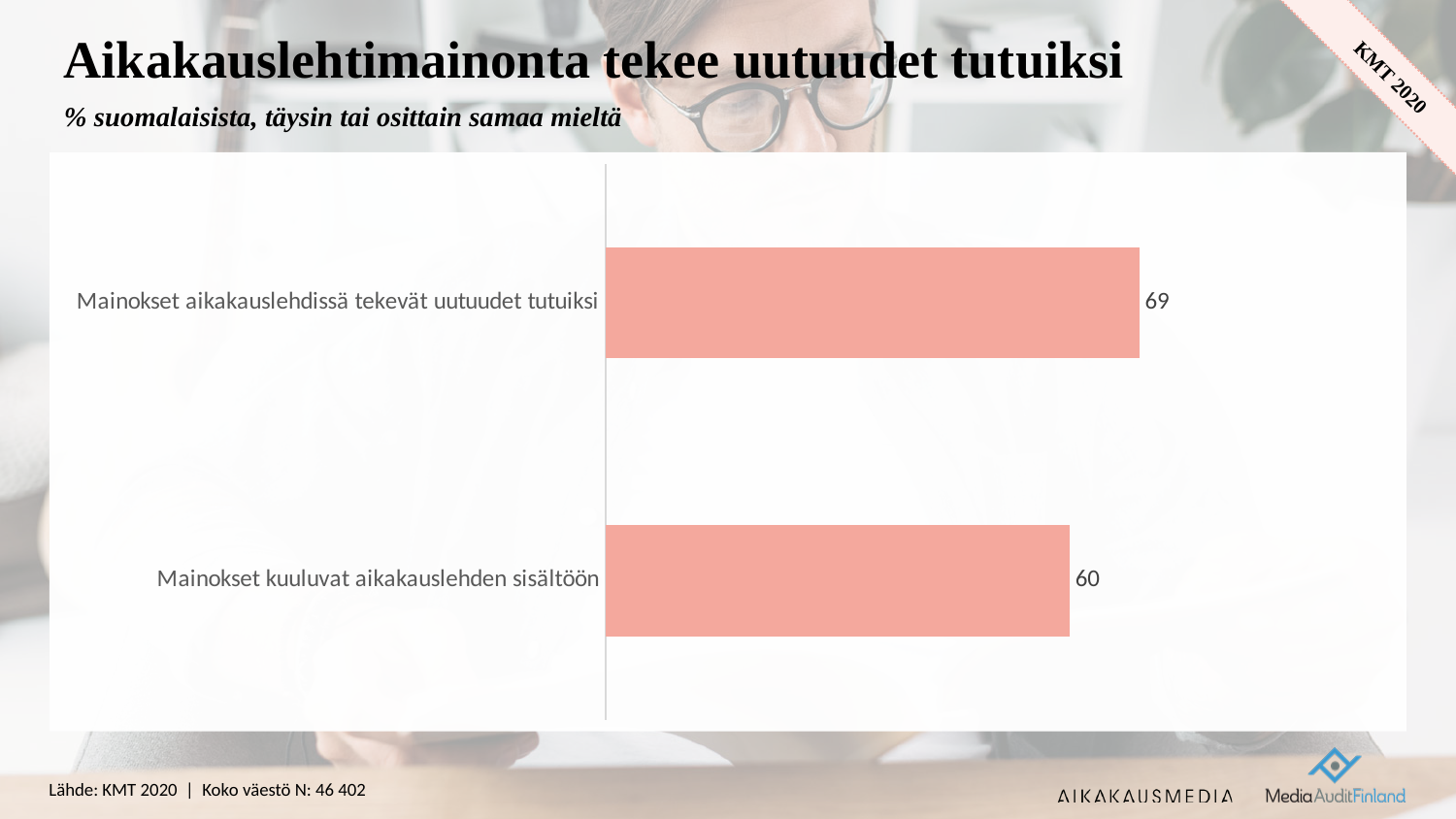
What is the title of the slide? Aikakauslehtimainonta tekee uutuudet tutuiksi What is the difference between the values for "Mainokset aikakauslehdissä tekevät uutuudet tutuiksi" and "Mainokset kuuluvat aikakauslehden sisältöön"? 9 Which category has the lowest value? Mainokset kuuluvat aikakauslehden sisältöön What is the value for "Mainokset kuuluvat aikakauslehden sisältöön"? 60 What colour are the bars in the chart? Salmon pink Which category has the highest value? Mainokset aikakauslehdissä tekevät uutuudet tutuiksi What is the value for "Mainokset aikakauslehdissä tekevät uutuudet tutuiksi"? 69 What kind of chart is shown on the slide? Bar chart How many categories are shown in the chart? 2 Which is larger: the value for "Mainokset aikakauslehdissä tekevät uutuudet tutuiksi" or for "Mainokset kuuluvat aikakauslehden sisältöön"? Mainokset aikakauslehdissä tekevät uutuudet tutuiksi